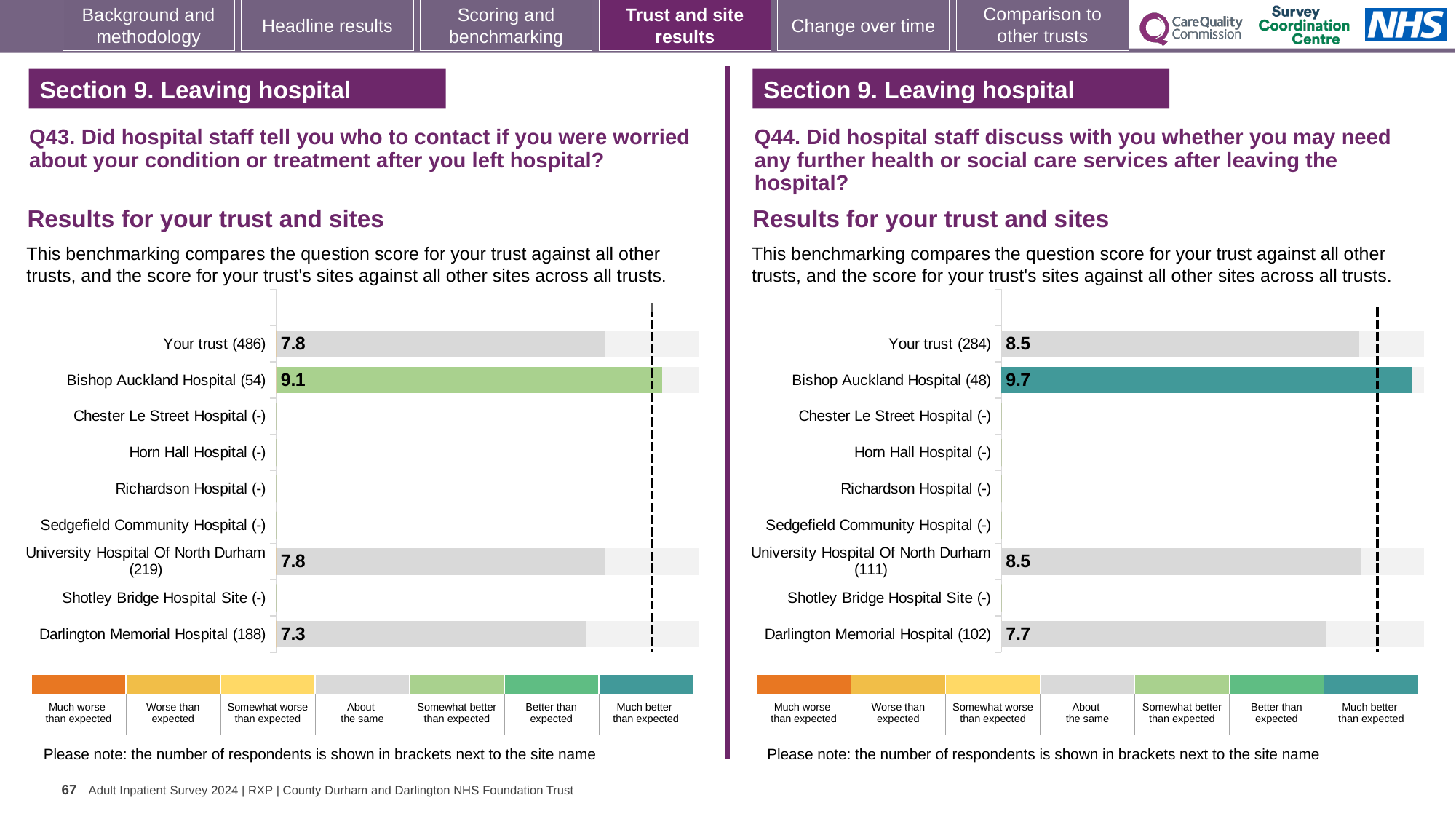
In the Q43 chart on the left, what is the score for Bishop Auckland Hospital? 9.1 How many site rows (including Your trust) are listed in the Q43 chart on the left? 9 In the Q43 chart on the left, which site has the highest score? Bishop Auckland Hospital In the Q44 chart on the right, what is the score for Your trust? 8.5 In the Q44 chart on the right, what is the difference between the Bishop Auckland Hospital score and the Darlington Memorial Hospital score? 2.0 In the Q43 chart on the left, what is the difference between the Bishop Auckland Hospital score and the Your trust score? 1.3 In the Q43 chart on the left, what is the score for Darlington Memorial Hospital? 7.3 In the Q44 chart on the right, which site has the lowest score among those with a bar? Darlington Memorial Hospital In the Q43 chart on the left, which site has the lowest score among those with a bar? Darlington Memorial Hospital Is the Darlington Memorial Hospital score higher in the Q43 chart or the Q44 chart? Q44 chart What type of chart is used in the Q44 chart on the right? Bar chart In the Q44 chart on the right, what is the score for Bishop Auckland Hospital? 9.7